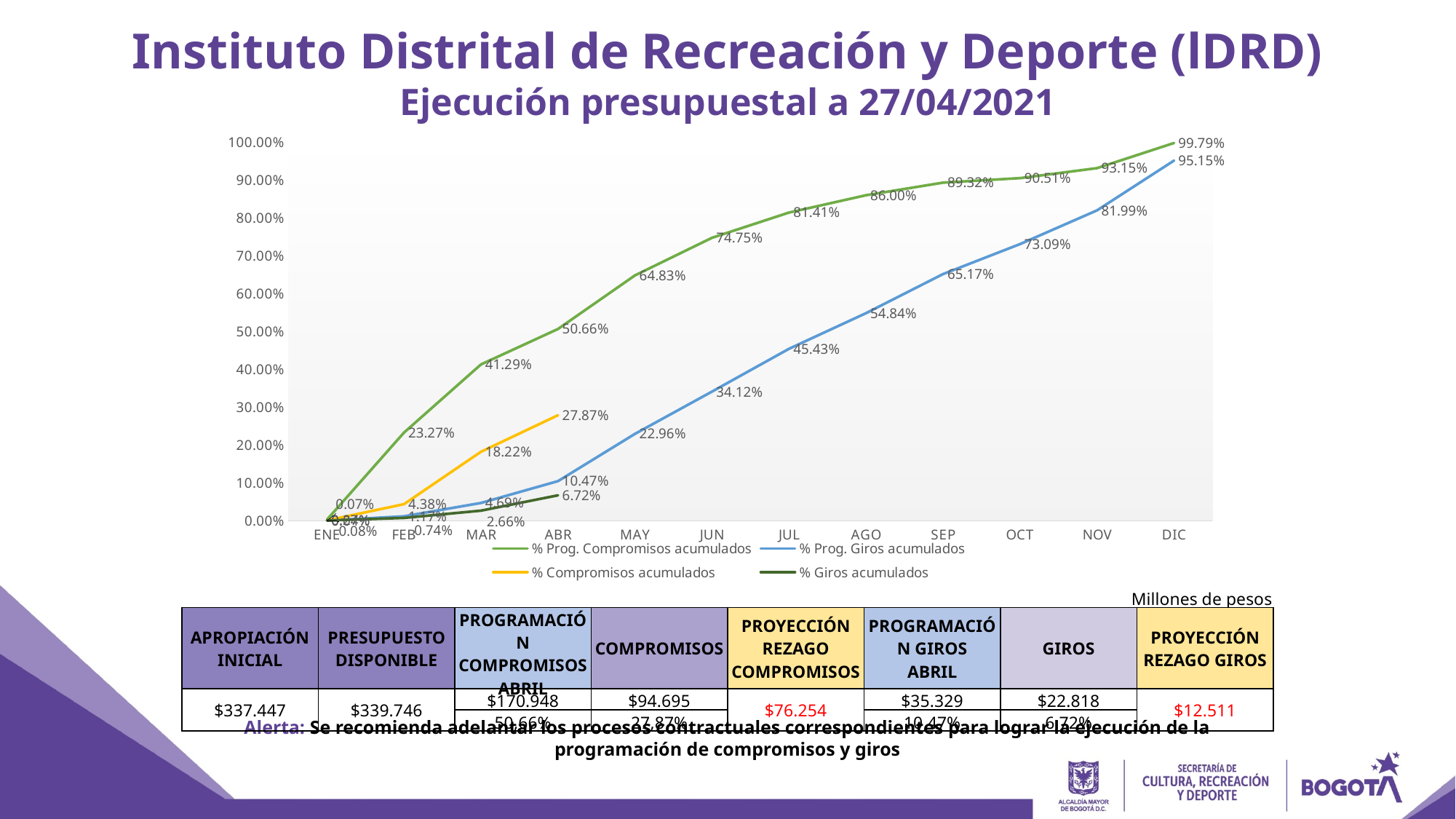
What is the value of % Compromisos acumulados in ABR? 27.87% What is the value of % Giros acumulados in ABR? 6.72% What is the value of % Prog. Giros acumulados in DIC? 95.15% Does the % Prog. Compromisos acumulados line rise or fall from ENE to DIC? Rise What is the value of % Prog. Giros acumulados in SEP? 65.17% How many series does the chart legend list? 4 In JUN, which is larger: % Prog. Compromisos acumulados or % Prog. Giros acumulados? % Prog. Compromisos acumulados In which month does % Prog. Giros acumulados reach its highest value? DIC What is the value of % Prog. Compromisos acumulados in DIC? 99.79% How many months are shown along the x axis of the chart? 12 What kind of chart is shown on the slide? Line chart What is the difference between % Prog. Compromisos acumulados and % Compromisos acumulados in ABR? 22.79%